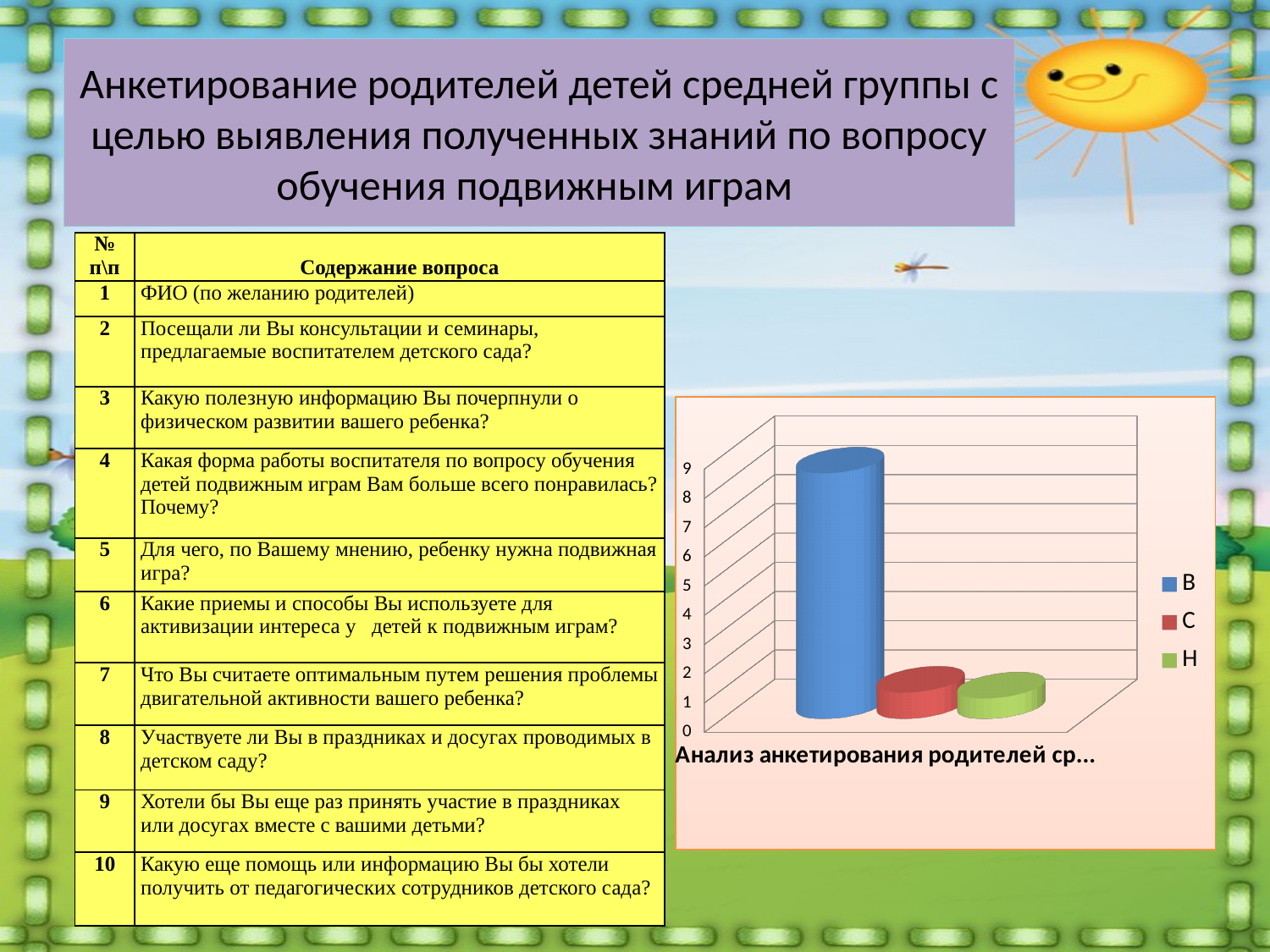
Which is larger, the value for В or the value for С? В What colour is the bar for series В in the chart? blue What colour is the bar for series Н in the chart? green How many bars are plotted in the chart? 3 What kind of chart is shown on the slide? bar chart Which is larger, the value for Н or the value for В? В Is the value for series Н greater or less than 4? less Which series has the highest bar in the chart? В How many series does the chart legend list? 3 Is the value for series С greater or less than 3? less What is the highest tick value shown on the chart's vertical axis? 9 Is the value for series В greater or less than 5? greater